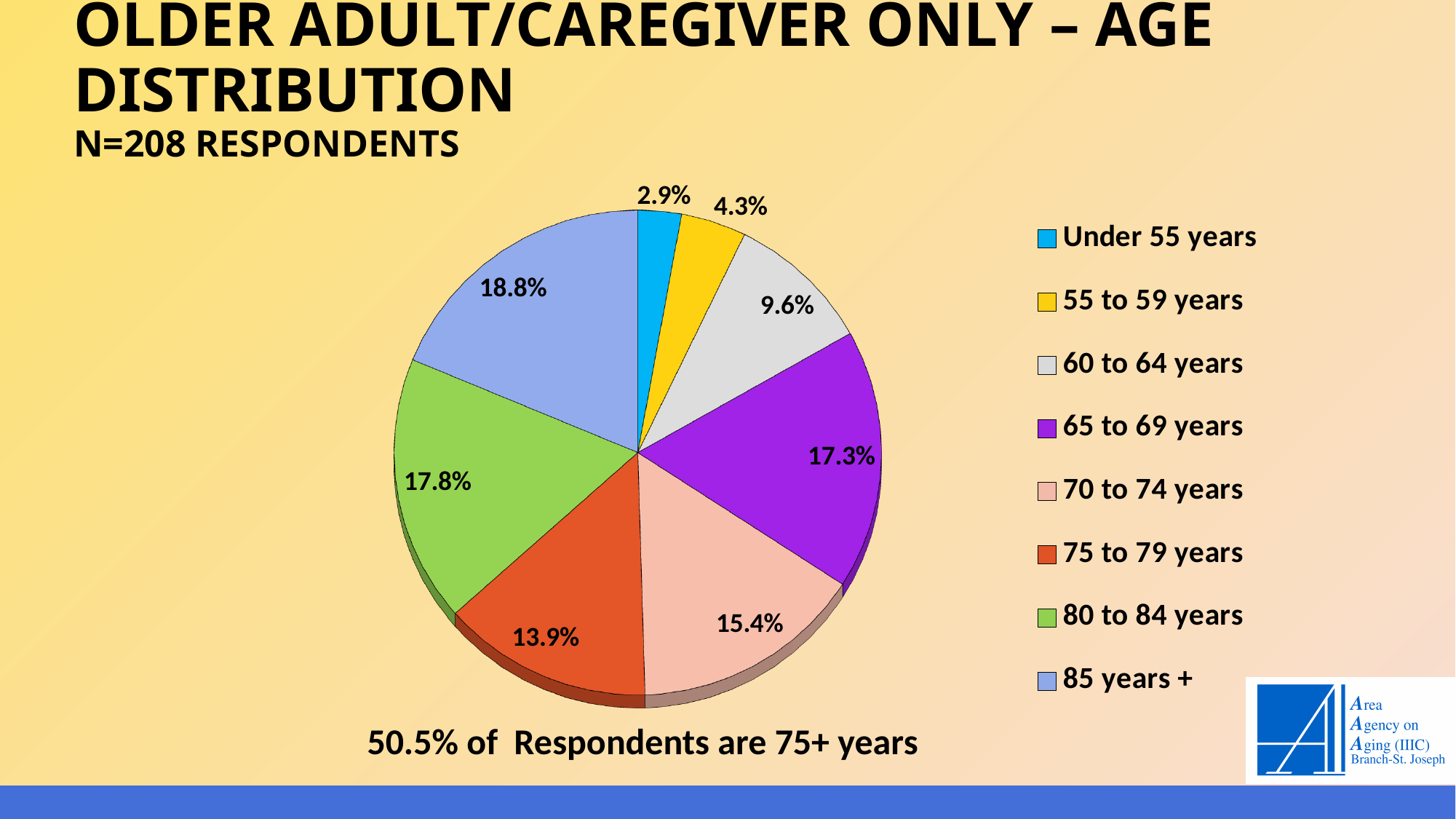
Which age group has the smallest share of respondents? Under 55 years What colour is the slice for 80 to 84 years? green What share of respondents are under 55 years? 2.9% How many respondents does the slide say were surveyed? 208 How many age groups are shown in the pie chart? 8 What share of respondents are 65 to 69 years? 17.3% Which is larger, the share for 60 to 64 years or the share for 55 to 59 years? 60 to 64 years Which age group has the largest share of respondents? 85 years + What share of respondents are 85 years +? 18.8% What is the difference in percentage points between the 80 to 84 years slice and the 70 to 74 years slice? 2.4 What kind of chart is shown on the slide? pie chart What share of respondents are 75 to 79 years? 13.9%